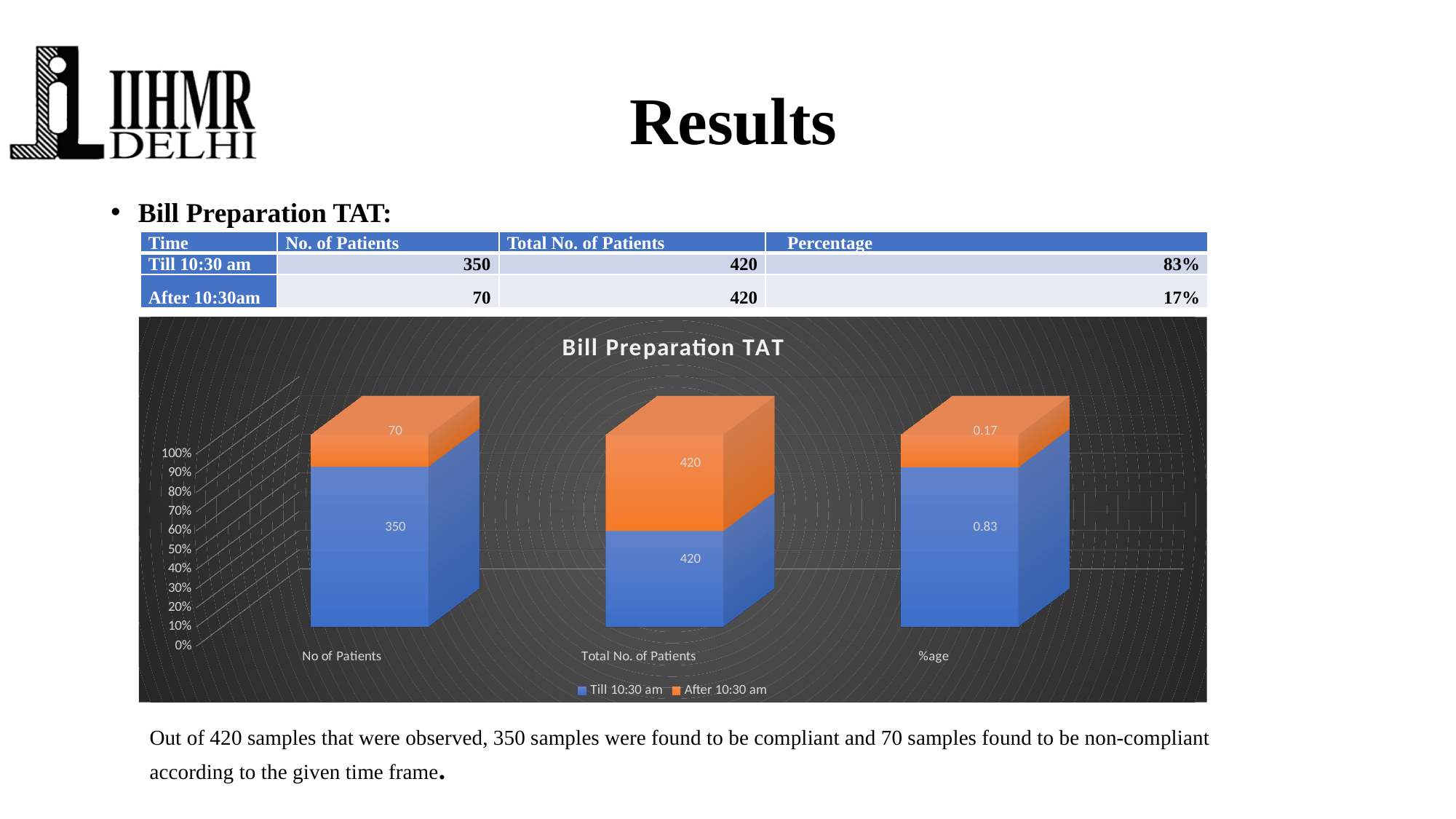
Which series has the larger value for No of Patients, Till 10:30 am or After 10:30 am? Till 10:30 am What is the value of the After 10:30 am series for No of Patients? 70 What is the value of the After 10:30 am series for Total No. of Patients? 420 How many series does the chart legend list? 2 What is the difference between the Till 10:30 am and After 10:30 am values for No of Patients? 280 How many categories are shown on the x axis of the chart? 3 What is the title of the chart? Bill Preparation TAT What is the value of the Till 10:30 am series for %age? 0.83 What is the value of the After 10:30 am series for %age? 0.17 Which series is shown in orange in the chart? After 10:30 am What kind of chart is shown on the slide? bar chart What is the value of the Till 10:30 am series for No of Patients? 350